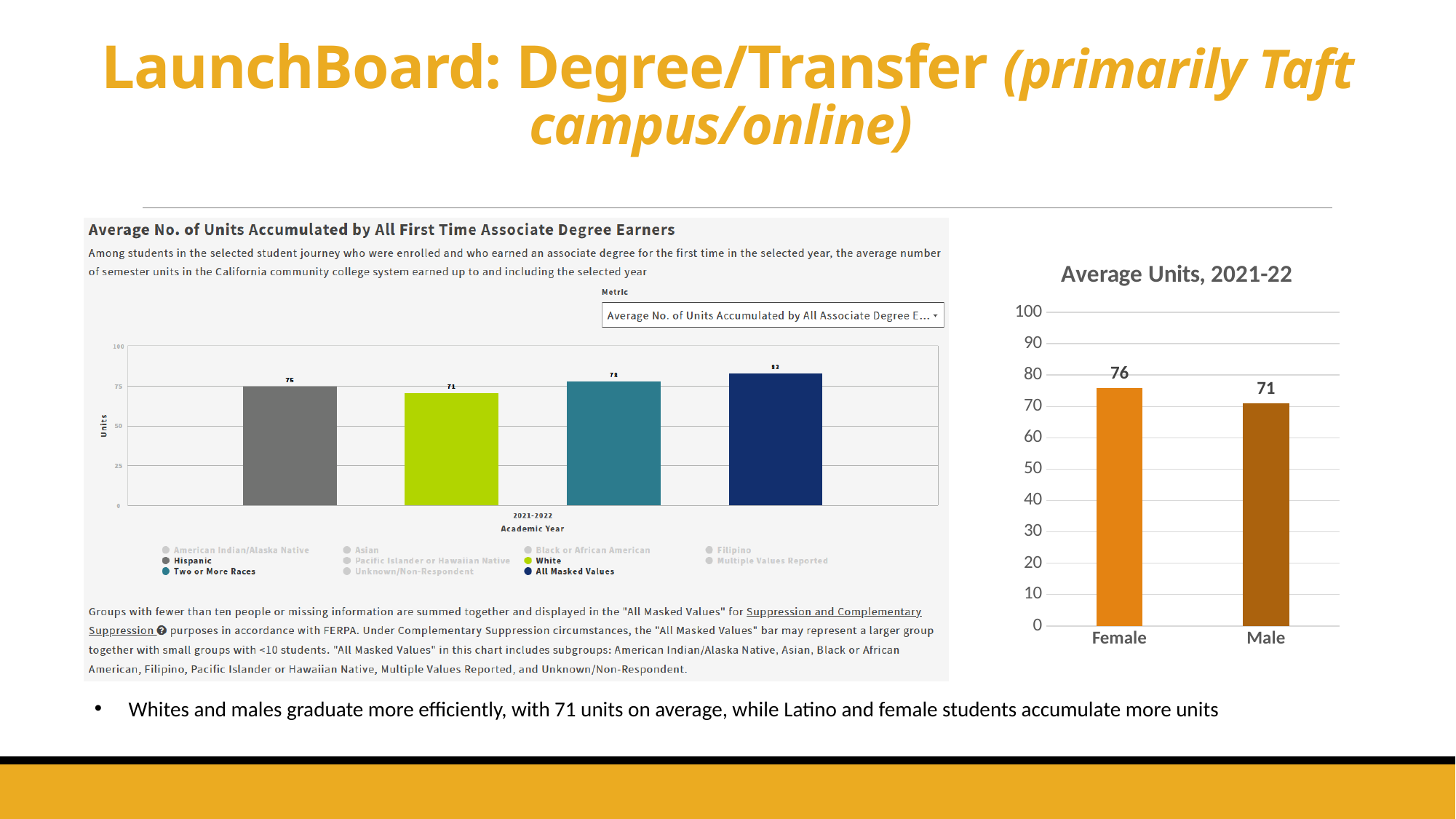
In the 'Average Units, 2021-22' chart, what is the value for Male? 71 In the 'Average Units, 2021-22' chart, what is the value for Female? 76 What kind of chart is 'Average Units, 2021-22'? Bar chart In the 'Average Units, 2021-22' chart, how many categories are plotted? 2 In the 'Average No. of Units Accumulated by All First Time Associate Degree Earners' chart, what is the difference between the All Masked Values bar and the Hispanic bar? 8 In the 'Average No. of Units Accumulated by All First Time Associate Degree Earners' chart, what is the value for Hispanic? 75 In the 'Average No. of Units Accumulated by All First Time Associate Degree Earners' chart, which group has the lowest value? White In the 'Average No. of Units Accumulated by All First Time Associate Degree Earners' chart, what is the value for White? 71 In the 'Average Units, 2021-22' chart, which category has the higher value, Female or Male? Female In the 'Average No. of Units Accumulated by All First Time Associate Degree Earners' chart, what is the value for Two or More Races? 78 In the 'Average No. of Units Accumulated by All First Time Associate Degree Earners' chart, which group has the highest value? All Masked Values In the 'Average Units, 2021-22' chart, what is the difference between the Female and Male values? 5